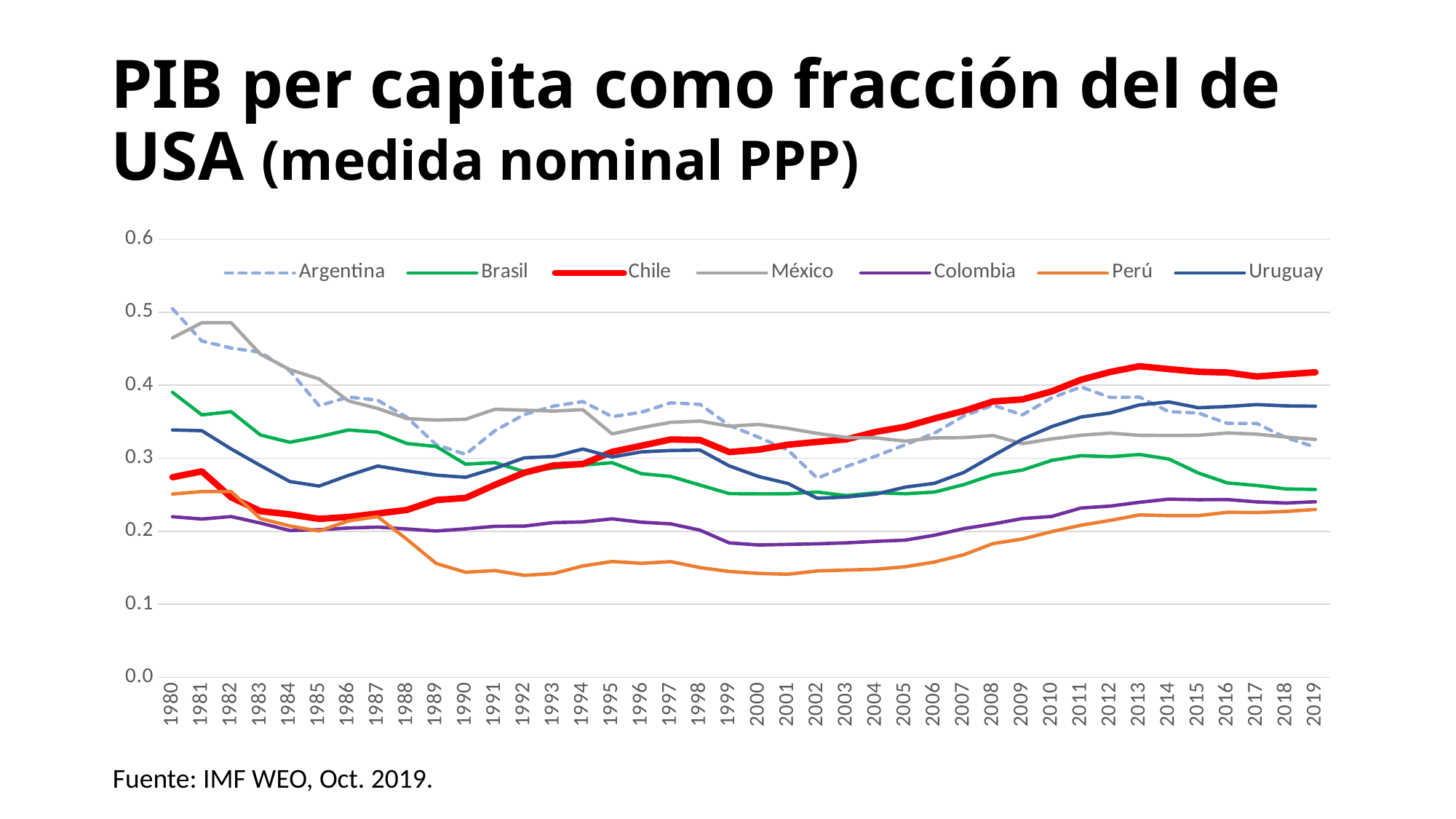
Does the value for Perú rise or fall between 1980 and 2000? fall In 1980, which is larger: the value for Argentina or the value for Chile? Argentina How many years are plotted along the x axis? 40 Which series has the lowest value in 2000? Perú Is the value for Perú in 2000 greater or less than 0.2? less Is the value for Chile in 2019 greater or less than 0.4? greater Which series is drawn with a dashed line? Argentina Which series has the highest value in 2019? Chile Does the value for Chile rise or fall between 1985 and 2013? rise Is the value for Brasil in 2019 greater or less than 0.3? less What kind of chart is shown on the slide? line chart How many series does the legend list? 7